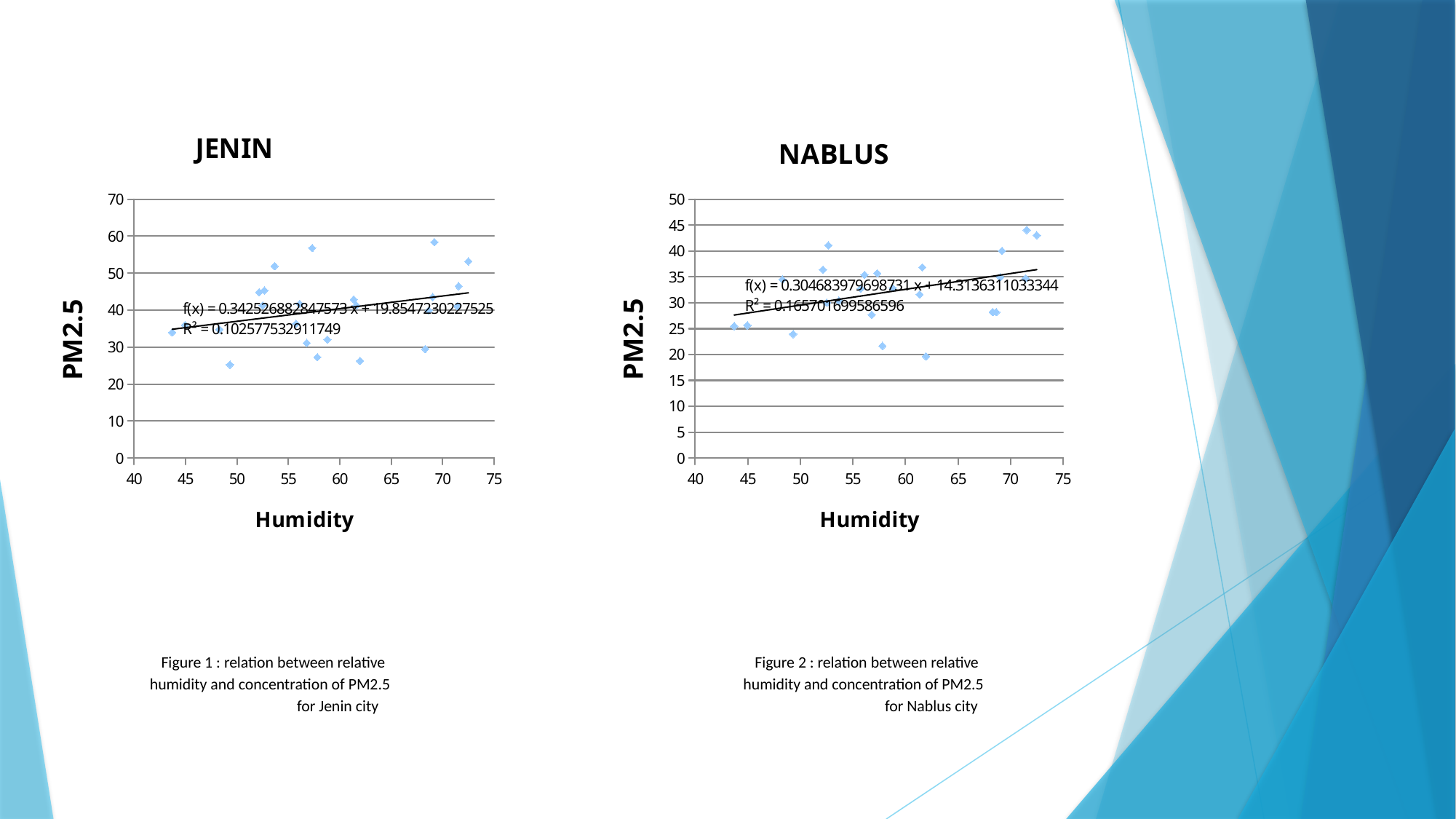
In the JENIN chart, is the highest PM2.5 value plotted greater or less than 50? greater In the NABLUS chart, does the fitted trendline rise or fall as humidity increases? rise What is the R² value shown on the NABLUS chart? 0.165701699586596 What kind of chart is the JENIN chart? scatter chart In the JENIN chart, is the lowest PM2.5 value plotted greater or less than 30? less In the JENIN chart, does the fitted trendline rise or fall as humidity increases? rise Which chart has the higher maximum value on its PM2.5 axis, JENIN or NABLUS? JENIN What kind of chart is the NABLUS chart? scatter chart What is the R² value shown on the JENIN chart? 0.102577532911749 In the NABLUS chart, is the lowest PM2.5 value plotted greater or less than 25? less